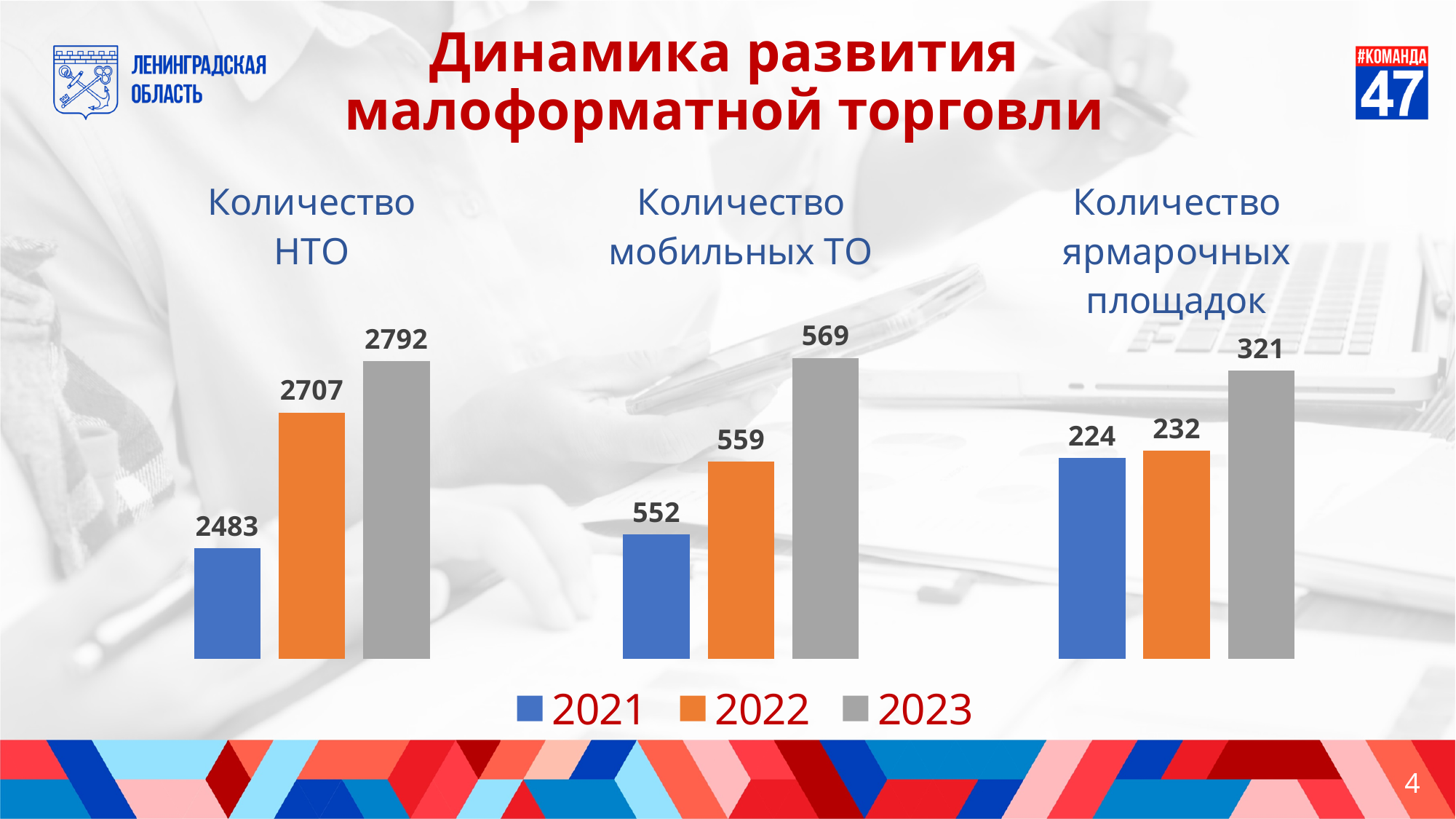
In the chart titled "Количество НТО", what is the value for 2021? 2483 Which colour represents 2022 in the legend? Orange What kind of chart is used on this slide? Bar chart How many series does the legend list? 3 In the chart titled "Количество ярмарочных площадок", which year has the lowest value? 2021 In the chart titled "Количество мобильных ТО", which is larger, the value for 2021 or the value for 2023? 2023 In the chart titled "Количество ярмарочных площадок", what is the difference between the 2023 and 2022 values? 89 In the chart titled "Количество мобильных ТО", do the values rise or fall from 2021 to 2023? Rise In the chart titled "Количество мобильных ТО", what is the value for 2023? 569 In the chart titled "Количество НТО", what is the difference between the 2023 and 2021 values? 309 In the chart titled "Количество НТО", which year has the highest value? 2023 In the chart titled "Количество ярмарочных площадок", what is the value for 2022? 232